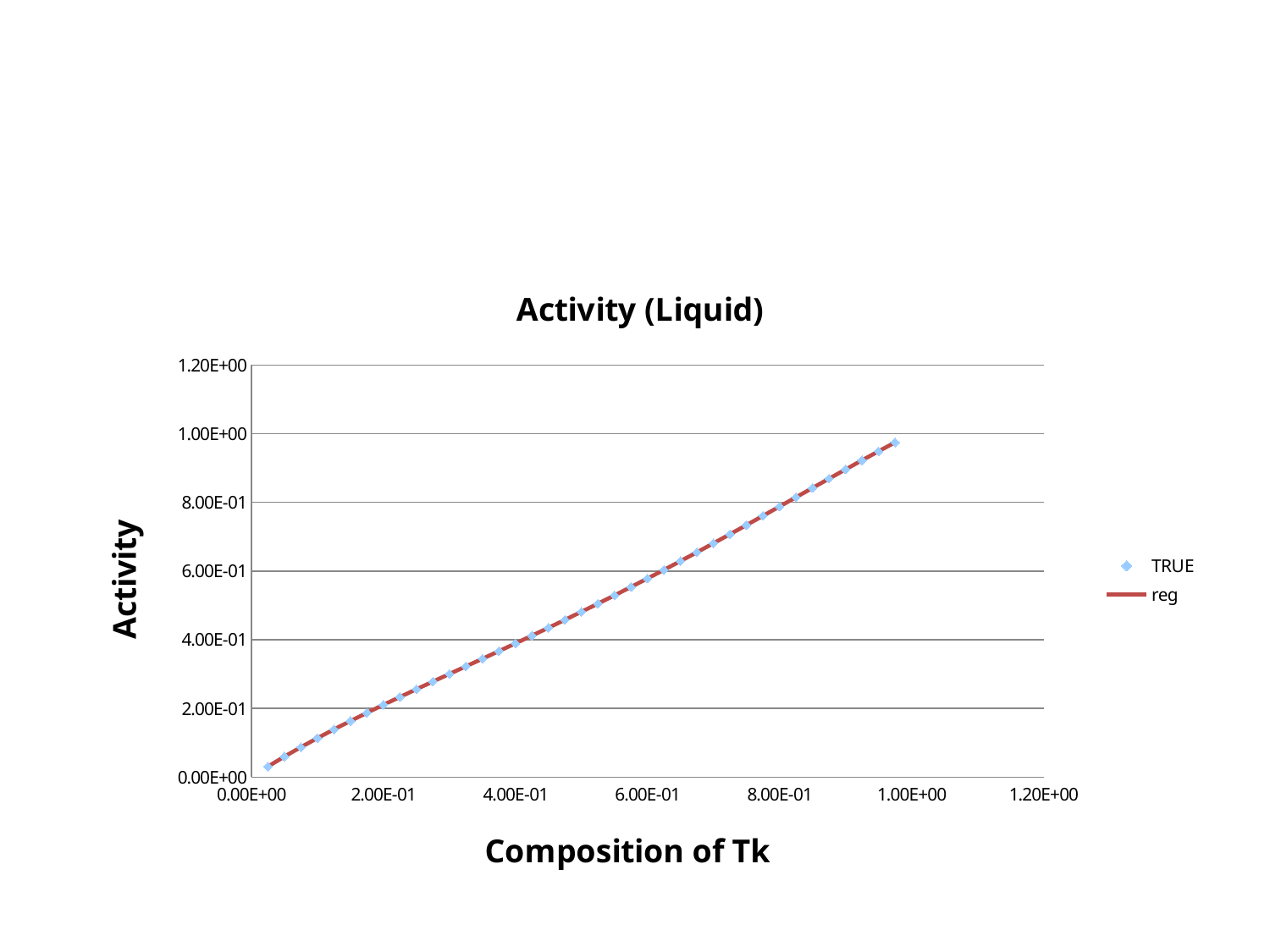
What is the label of the x axis? Composition of Tk What kind of chart is shown? Scatter chart with a fitted line Do the Activity values rise or fall as Composition of Tk increases? Rise Is the Activity value at Composition of Tk = 2.00E-01 greater or less than 4.00E-01? less Is the Activity value at Composition of Tk = 8.00E-01 greater or less than 6.00E-01? greater How many series does the legend list? 2 What are the names of the series in the legend? TRUE and reg Is the Activity value of the lowest TRUE point greater or less than 2.00E-01? less What is the title of the chart? Activity (Liquid)